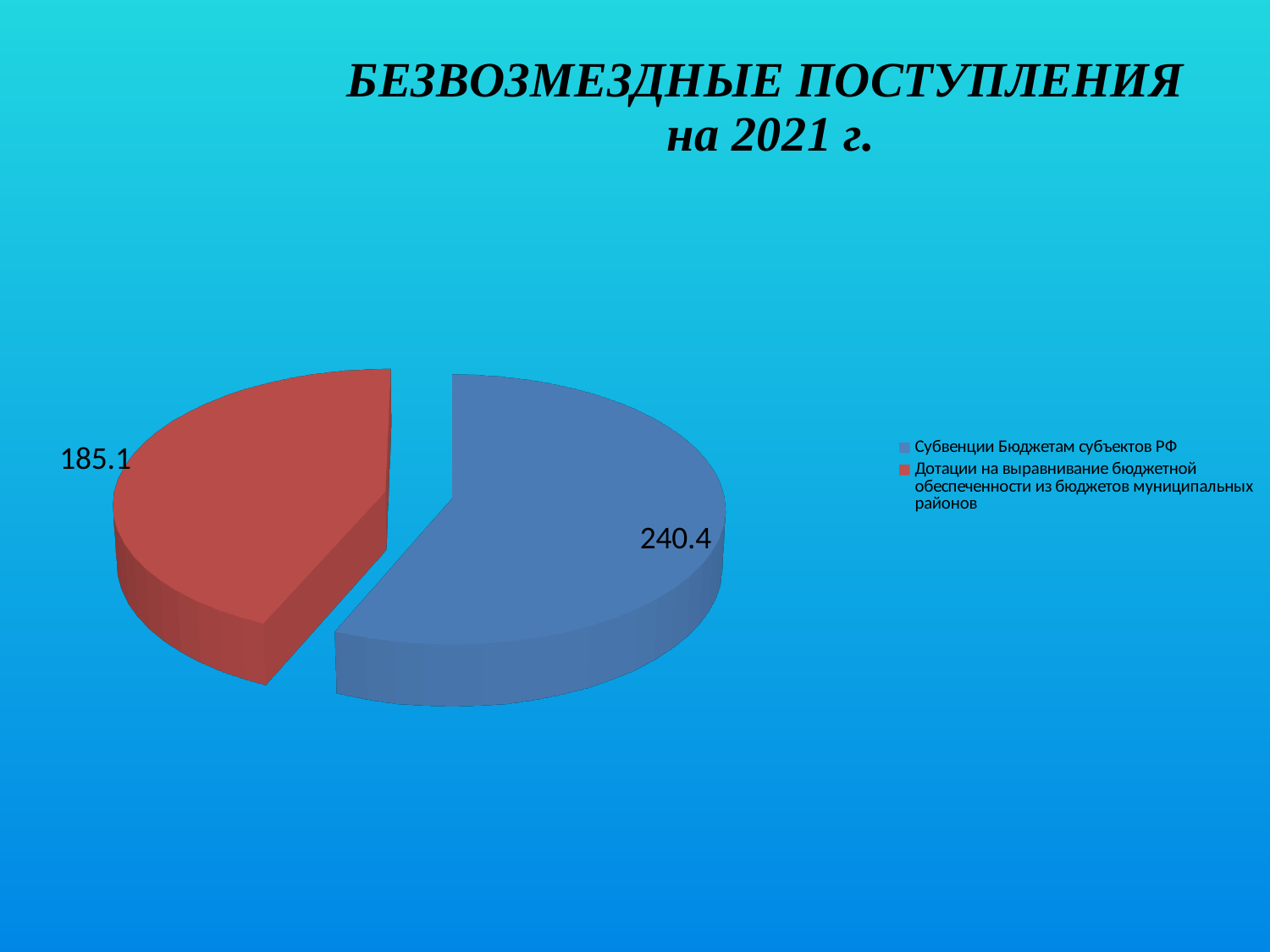
What is the difference between the value for Субвенции Бюджетам субъектов РФ and the value for Дотации на выравнивание бюджетной обеспеченности из бюджетов муниципальных районов? 55.3 How many slices does the pie chart have? 2 What is the value for Дотации на выравнивание бюджетной обеспеченности из бюджетов муниципальных районов? 185.1 What is the total of the two values shown in the pie chart? 425.5 What is the value for Субвенции Бюджетам субъектов РФ? 240.4 What type of chart is shown on the slide? Pie chart Which is larger: the value for Субвенции Бюджетам субъектов РФ or the value for Дотации на выравнивание бюджетной обеспеченности из бюджетов муниципальных районов? Субвенции Бюджетам субъектов РФ How many entries does the legend list? 2 Which category has the smallest slice of the pie? Дотации на выравнивание бюджетной обеспеченности из бюджетов муниципальных районов Which category has the largest slice of the pie? Субвенции Бюджетам субъектов РФ What colour is the slice for Дотации на выравнивание бюджетной обеспеченности из бюджетов муниципальных районов? Red What is the title of the slide containing the chart? БЕЗВОЗМЕЗДНЫЕ ПОСТУПЛЕНИЯ на 2021 г.